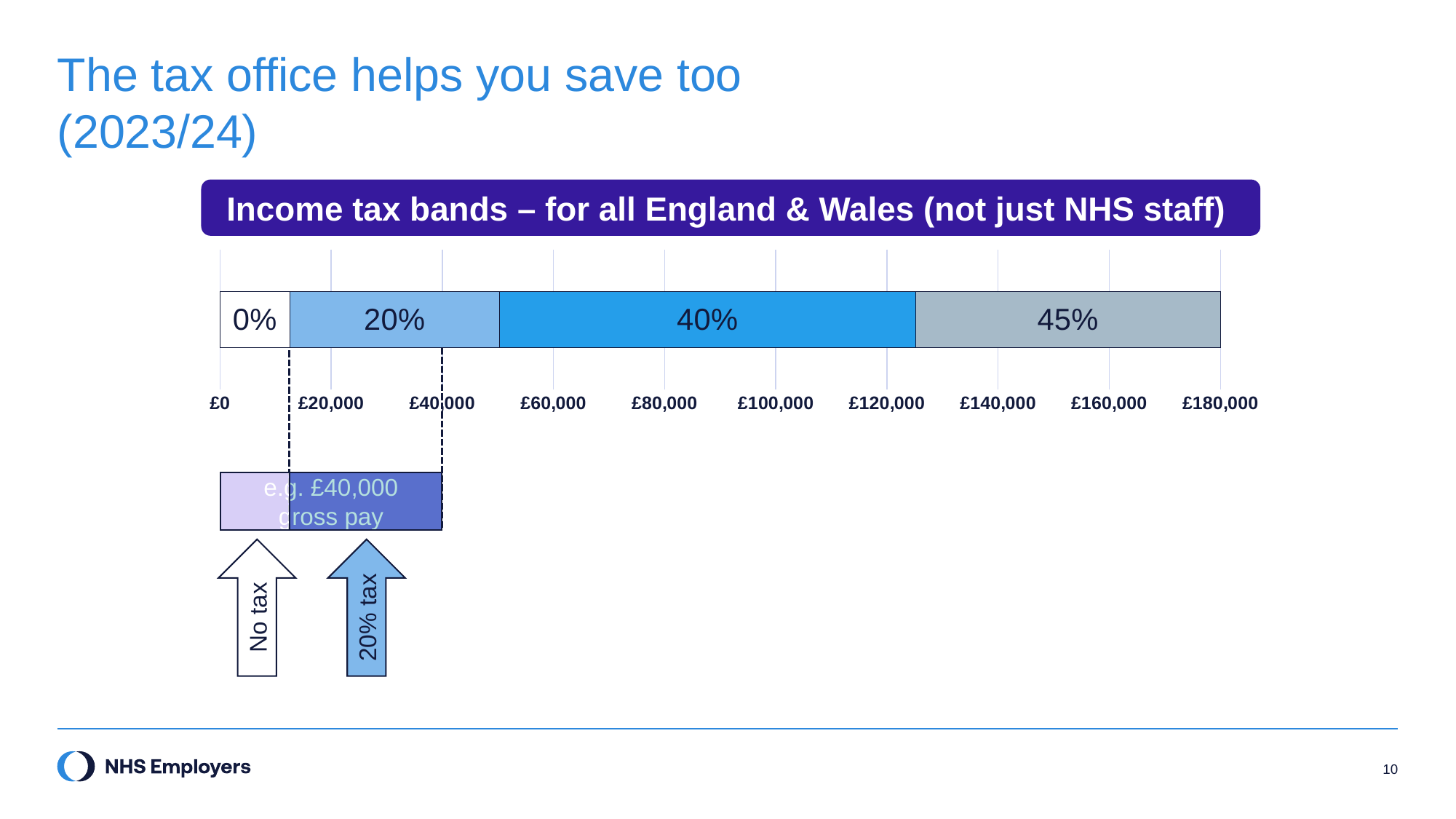
What example gross pay is shown below the income tax bands bar? £40,000 Is the upper end of the 0% tax band greater or less than £20,000? less Which segment is wider in the income tax bands bar, the 20% band or the 45% band? 45% What kind of chart is used to show the income tax bands? bar chart What is the title shown above the income tax bands bar? Income tax bands – for all England & Wales (not just NHS staff) What tax rate is labelled on the segment immediately to the right of the 20% band? 40% How many tax band segments are shown in the income tax bands bar? 4 What tax rate is labelled on the widest segment of the income tax bands bar? 40% Is the upper end of the 40% tax band greater or less than £120,000? greater What tax rate is labelled on the narrowest segment of the income tax bands bar? 0% What is the highest value labelled on the income axis of the tax bands chart? £180,000 Is the upper end of the 20% tax band greater or less than £40,000? greater